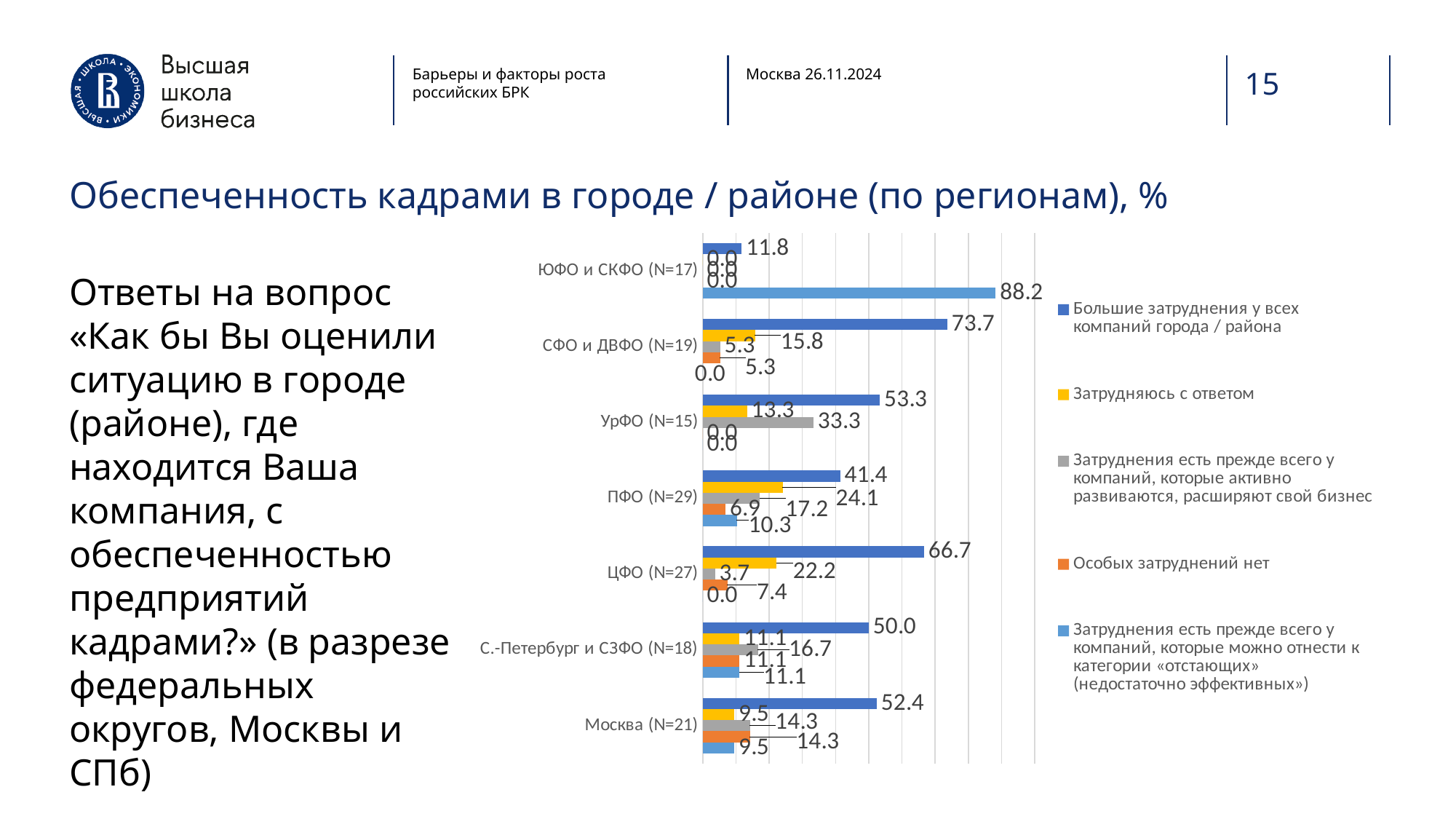
What is the difference between the «Большие затруднения у всех компаний города / района» values for ЦФО (N=27) and ПФО (N=29)? 25.3 What is the value for «Большие затруднения у всех компаний города / района» for Москва (N=21)? 52.4 How many regions (categories) are shown on the chart? 7 What type of chart is shown on the slide? bar chart What is the value for «Большие затруднения у всех компаний города / района» for СФО и ДВФО (N=19)? 73.7 Which region has the highest value for «Большие затруднения у всех компаний города / района»? СФО и ДВФО (N=19) Which is larger for УрФО (N=15): «Затрудняюсь с ответом» or «Затруднения есть прежде всего у компаний, которые активно развиваются, расширяют свой бизнес»? Затруднения есть прежде всего у компаний, которые активно развиваются, расширяют свой бизнес What is the title of the chart on the slide? Обеспеченность кадрами в городе / районе (по регионам), % How many series does the legend list? 5 What is the value for «Затрудняюсь с ответом» for ПФО (N=29)? 24.1 What is the value for «Затруднения есть прежде всего у компаний, которые можно отнести к категории «отстающих»» for ЮФО и СКФО (N=17)? 88.2 Which region has the lowest value for «Большие затруднения у всех компаний города / района»? ЮФО и СКФО (N=17)